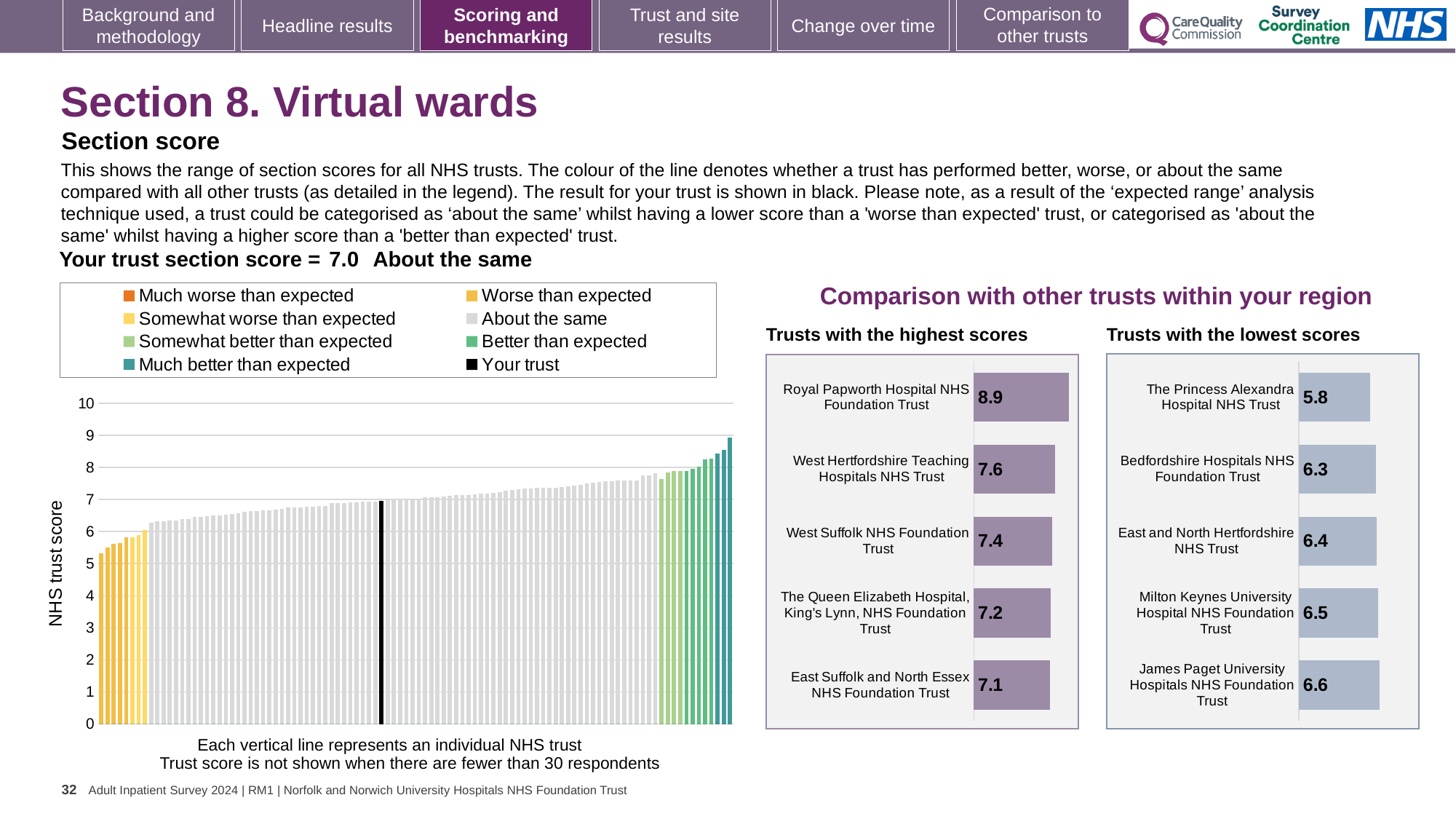
In the 'Trusts with the lowest scores' chart, what is the difference between the scores of James Paget University Hospitals NHS Foundation Trust and The Princess Alexandra Hospital NHS Trust? 0.8 In the 'Trusts with the lowest scores' chart, which trust has the lowest score? The Princess Alexandra Hospital NHS Trust In the 'Trusts with the highest scores' chart, which trust has the lowest score shown? East Suffolk and North Essex NHS Foundation Trust In the 'Trusts with the lowest scores' chart, what is the score for Bedfordshire Hospitals NHS Foundation Trust? 6.3 In the 'Trusts with the highest scores' chart, which has the higher score: West Suffolk NHS Foundation Trust or The Queen Elizabeth Hospital, King's Lynn, NHS Foundation Trust? West Suffolk NHS Foundation Trust In the NHS trust score chart on the left, is the value of the tallest bar greater or less than 8? greater How many entries does the legend of the NHS trust score chart on the left list? 8 How many trusts are shown in the 'Trusts with the lowest scores' chart? 5 In the NHS trust score chart on the left, what is the section score for your trust? 7.0 In the 'Trusts with the highest scores' chart, what is the difference between the scores of Royal Papworth Hospital NHS Foundation Trust and West Hertfordshire Teaching Hospitals NHS Trust? 1.3 In the 'Trusts with the highest scores' chart, what is the score for Royal Papworth Hospital NHS Foundation Trust? 8.9 In the NHS trust score chart on the left, do the bar values rise or fall from left to right? rise